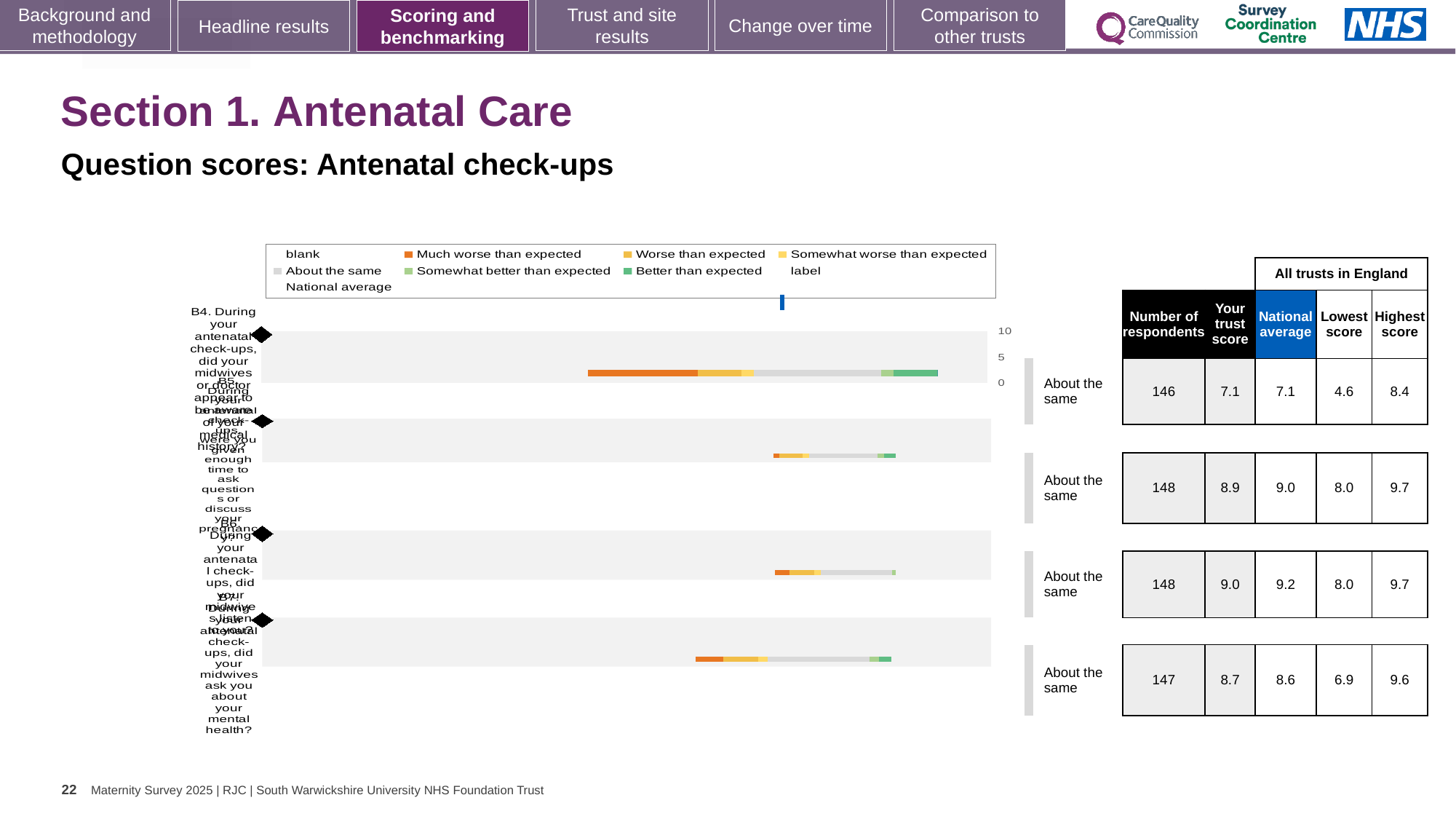
Which row has the lowest 'Lowest score' value in the table? Top row (B4), 4.6 What benchmark label is shown for each of the four questions? About the same For the third row (B6), which is larger: the trust score or the national average? National average In the table next to the chart, what is the number of respondents for the top row (B4)? 146 How many questions (bars) are plotted in the chart? 4 What kind of chart is shown on the slide? Bar chart What is the highest score for the bottom row (B7) in the table? 9.6 What is the national average for the second row (B5) in the table? 9.0 Which row has the highest 'Your trust score' in the table? Third row (B6), 9.0 For the bottom row (B7), what is the difference between the trust score and the national average? 0.1 What is the 'Your trust score' for the top row (B4) in the table? 7.1 What colour represents 'Much worse than expected' in the legend? Orange